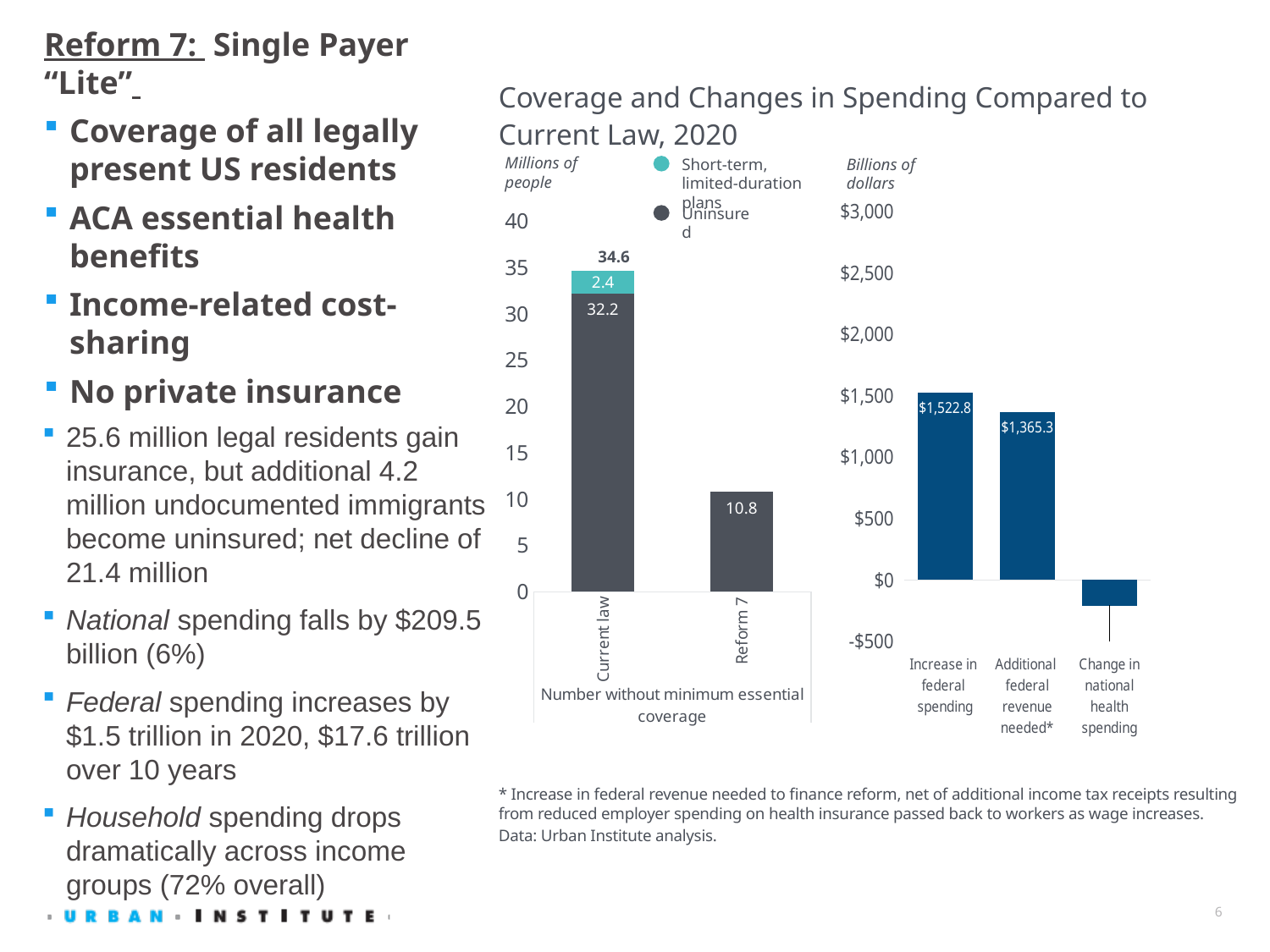
In the right chart (Billions of dollars), how many categories are shown on the x axis? 3 In the right chart (Billions of dollars), what is the value for Increase in federal spending? $1,522.8 In the left chart (Number without minimum essential coverage), what is the value for Reform 7? 10.8 In the right chart (Billions of dollars), what is the value for Additional federal revenue needed*? $1,365.3 What kind of chart is the right chart (Billions of dollars)? bar chart In the left chart (Number without minimum essential coverage), what is the Uninsured value for Current law? 32.2 In the right chart (Billions of dollars), is the value for Change in national health spending greater or less than $0? less In the right chart (Billions of dollars), which category has the highest value? Increase in federal spending In the left chart (Number without minimum essential coverage), what is the value for Short-term, limited-duration plans under Current law? 2.4 In the left chart (Number without minimum essential coverage), how many series does the legend list? 2 In the left chart (Number without minimum essential coverage), what is the total of the stacked bar for Current law? 34.6 In the left chart (Number without minimum essential coverage), what is the difference between the Uninsured value for Current law and the value for Reform 7? 21.4